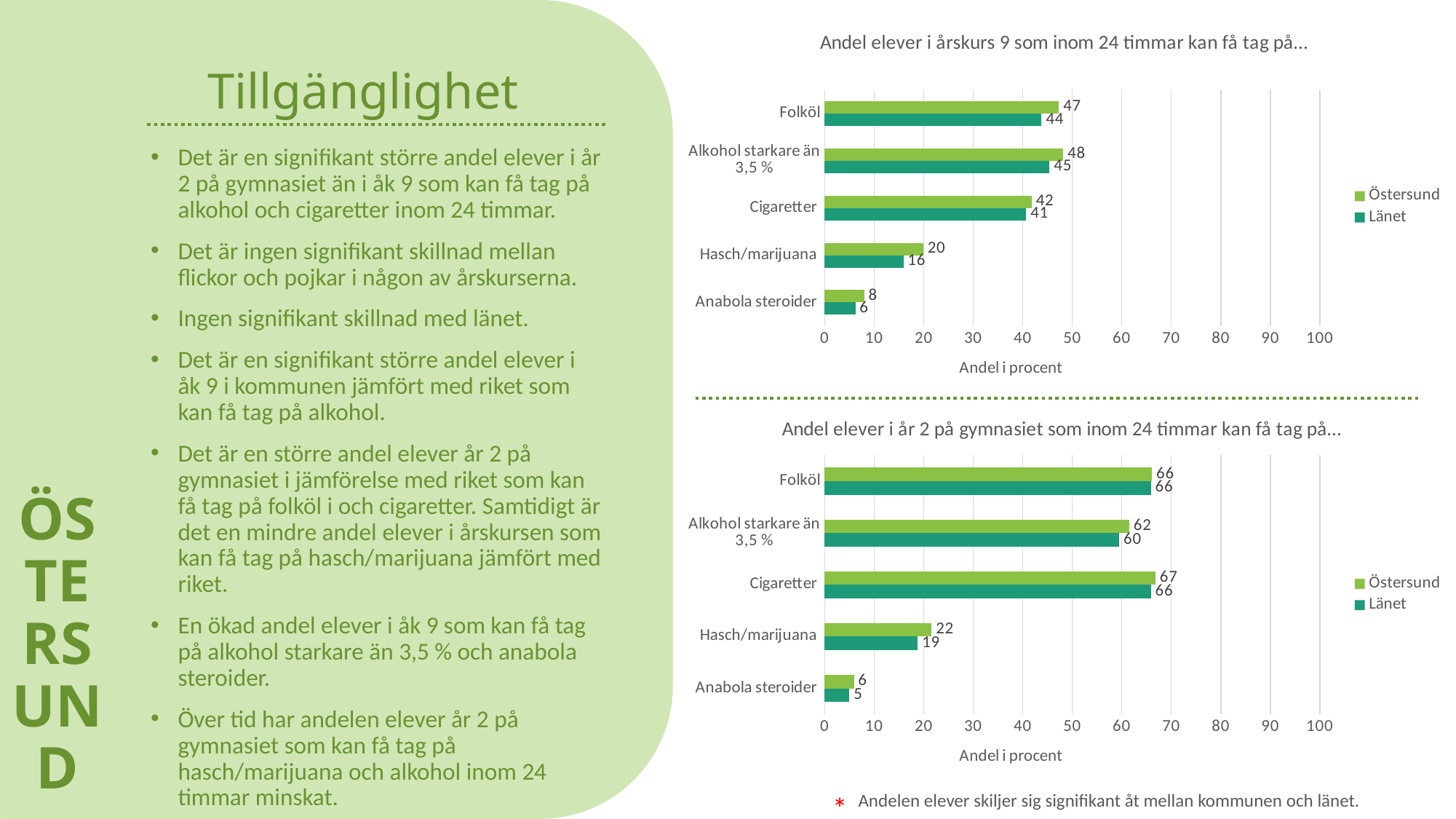
In the top chart (årskurs 9), what is the difference between the Östersund and Länet values for Hasch/marijuana? 4 In the top chart (årskurs 9), what is the value for Länet for Hasch/marijuana? 16 In the bottom chart (år 2 på gymnasiet), what is the difference between the Östersund and Länet values for Hasch/marijuana? 3 In the bottom chart (år 2 på gymnasiet), what is the value for Östersund for Cigaretter? 67 How many categories are shown in the top chart (årskurs 9)? 5 In the top chart (årskurs 9), what is the value for Östersund for Folköl? 47 How many series does the legend of the bottom chart (år 2 på gymnasiet) list? 2 In the bottom chart (år 2 på gymnasiet), what is the value for Länet for Anabola steroider? 5 In the bottom chart (år 2 på gymnasiet), which category has the lowest value for Länet? Anabola steroider In the top chart (årskurs 9), which category has the highest value for Östersund? Alkohol starkare än 3,5 % What kind of chart is the top chart (årskurs 9)? Bar chart In the bottom chart (år 2 på gymnasiet), which is larger for Cigaretter: Östersund or Länet? Östersund